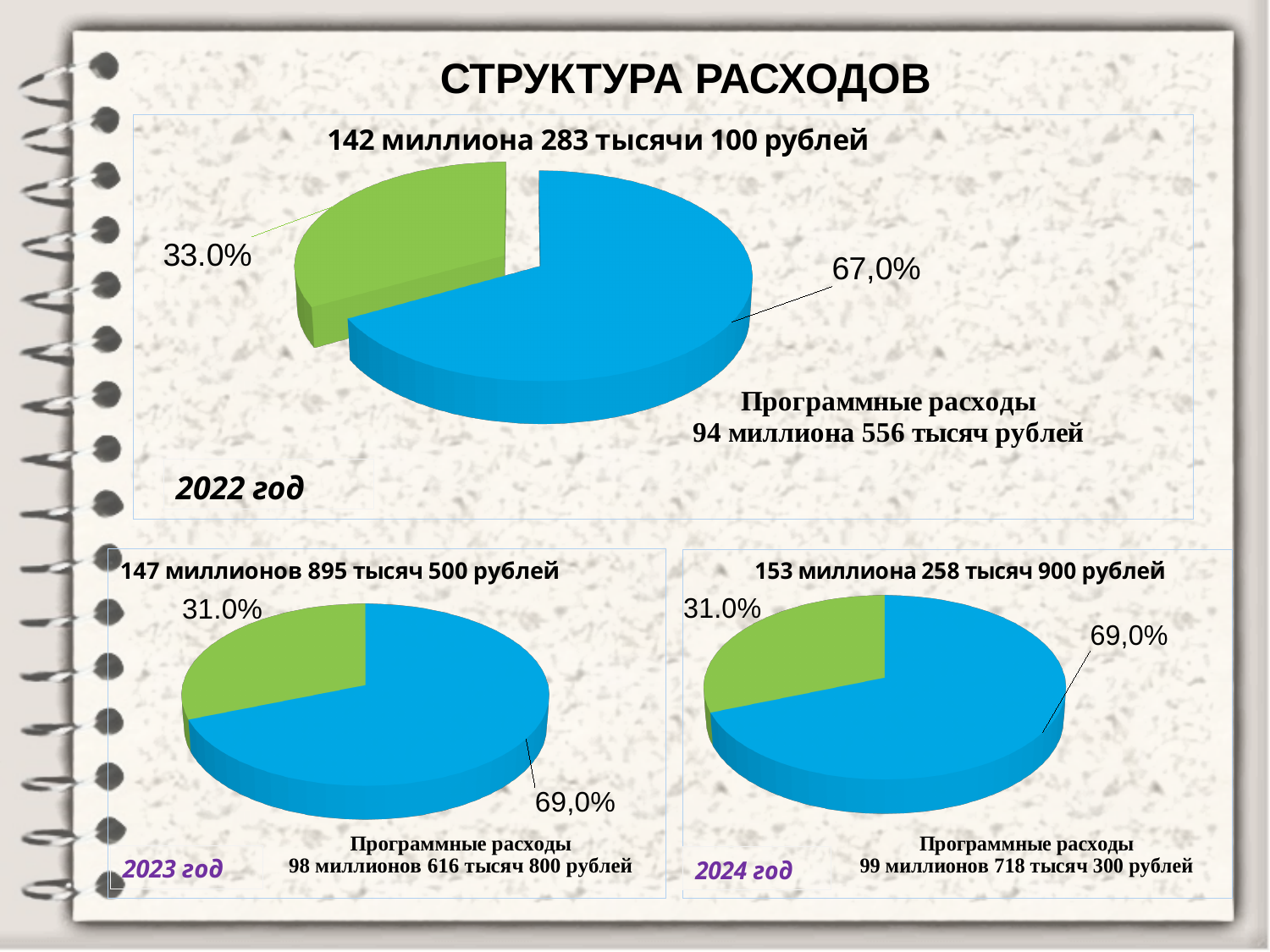
In the 2023 год pie chart, what is the difference between the blue slice's share and the green slice's share? 38 percentage points How many slices does the 2024 год pie chart have? 2 In the 2022 год pie chart, what share is shown for the blue slice (Программные расходы)? 67,0% How many pie charts are shown on the slide? 3 What amount of Программные расходы is stated next to the 2024 год pie chart? 99 миллионов 718 тысяч 300 рублей In the 2022 год pie chart, which slice is larger, the blue one or the green one? the blue one In the 2024 год pie chart, what share is shown for the green slice? 31.0% In the 2022 год pie chart, what share is shown for the green slice? 33.0% What total amount is shown as the title of the 2023 год pie chart? 147 миллионов 895 тысяч 500 рублей What kind of chart is used for the 2022 год data? pie chart In the 2022 год pie chart, what is the difference between the blue slice's share and the green slice's share? 34 percentage points